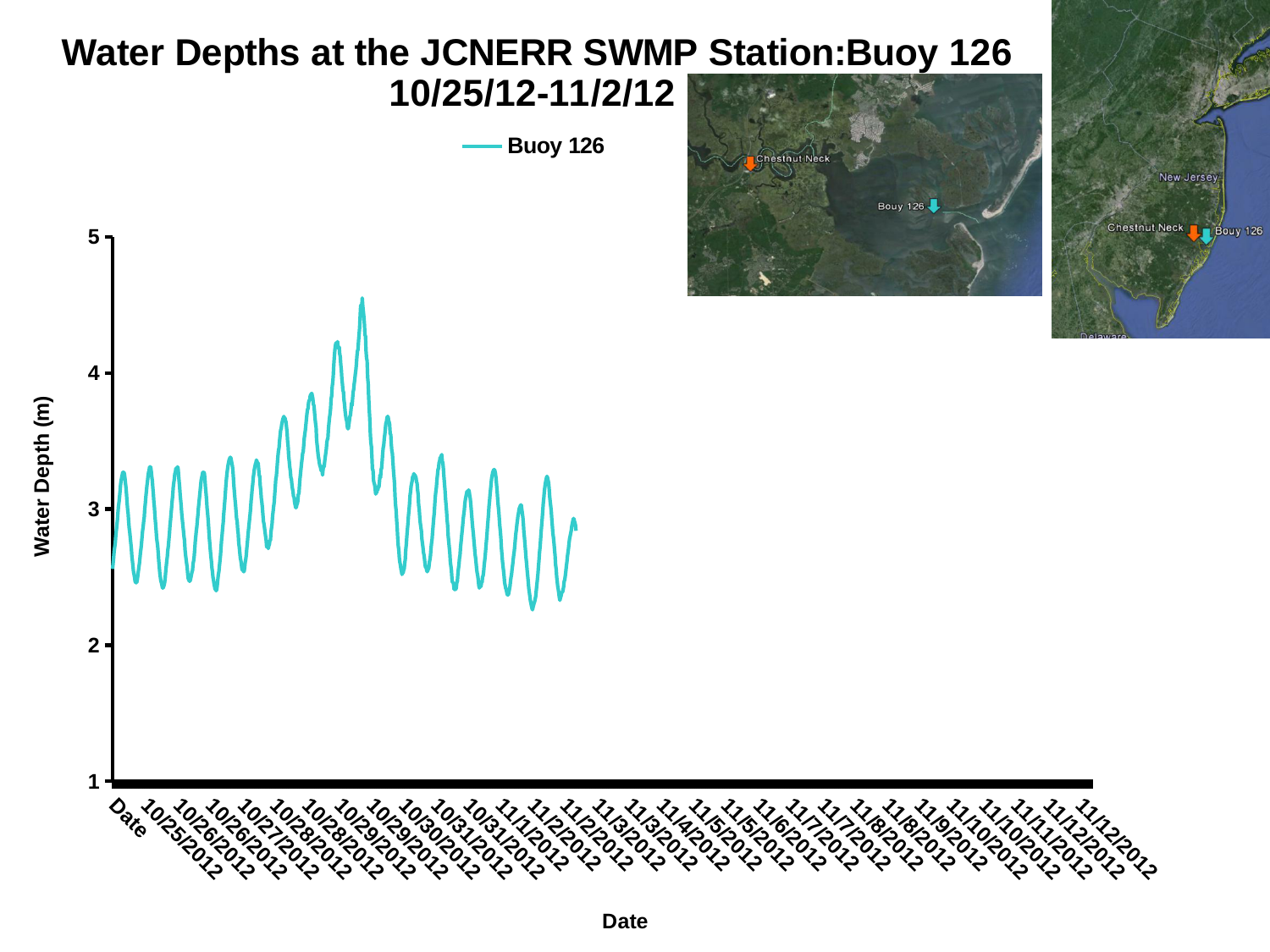
Around which date does the highest water depth peak occur? 10/29/2012 Is the highest water depth reached on the chart greater or less than 4? greater How many series does the chart legend list? 1 What is the label on the vertical axis of the chart? Water Depth (m) What is the name of the series shown in the chart legend? Buoy 126 Is the lowest water depth reached on the chart greater or less than 3? less What kind of chart is shown on the slide? line chart Is the lowest water depth reached on the chart greater or less than 2? greater Is the peak water depth around 10/29/2012 larger or smaller than the peak around 11/2/2012? larger